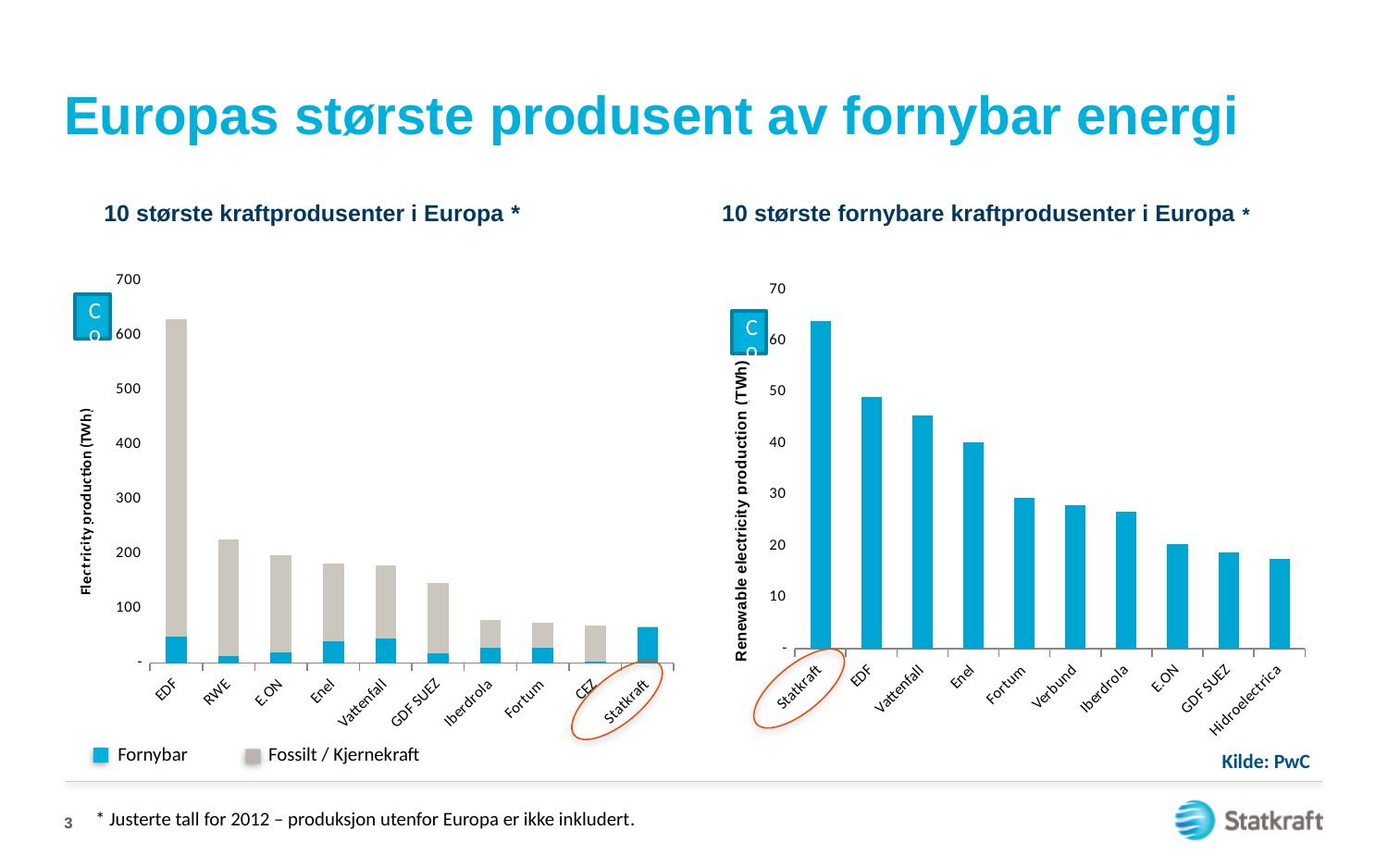
How many series does the legend of the left chart ('10 største kraftprodusenter i Europa *') list? 2 What kind of chart is the chart titled '10 største fornybare kraftprodusenter i Europa *'? bar chart In the left chart ('10 største kraftprodusenter i Europa *'), which legend entry is shown in grey? Fossilt / Kjernekraft In the right chart ('10 største fornybare kraftprodusenter i Europa *'), is the value for Statkraft greater or less than 60? greater In the right chart ('10 største fornybare kraftprodusenter i Europa *'), which is larger, the value for Vattenfall or the value for Fortum? Vattenfall How many producers are shown on the x axis of the chart titled '10 største kraftprodusenter i Europa *'? 10 In the left chart ('10 største kraftprodusenter i Europa *'), which producer has the highest total electricity production? EDF In the right chart ('10 største fornybare kraftprodusenter i Europa *'), is the value for Hidroelectrica greater or less than 20? less In the left chart ('10 største kraftprodusenter i Europa *'), is the total value for Vattenfall greater or less than 200? less In the right chart ('10 største fornybare kraftprodusenter i Europa *'), which producer has the highest renewable electricity production? Statkraft In the right chart ('10 største fornybare kraftprodusenter i Europa *'), do the values rise or fall from left to right along the x axis? fall